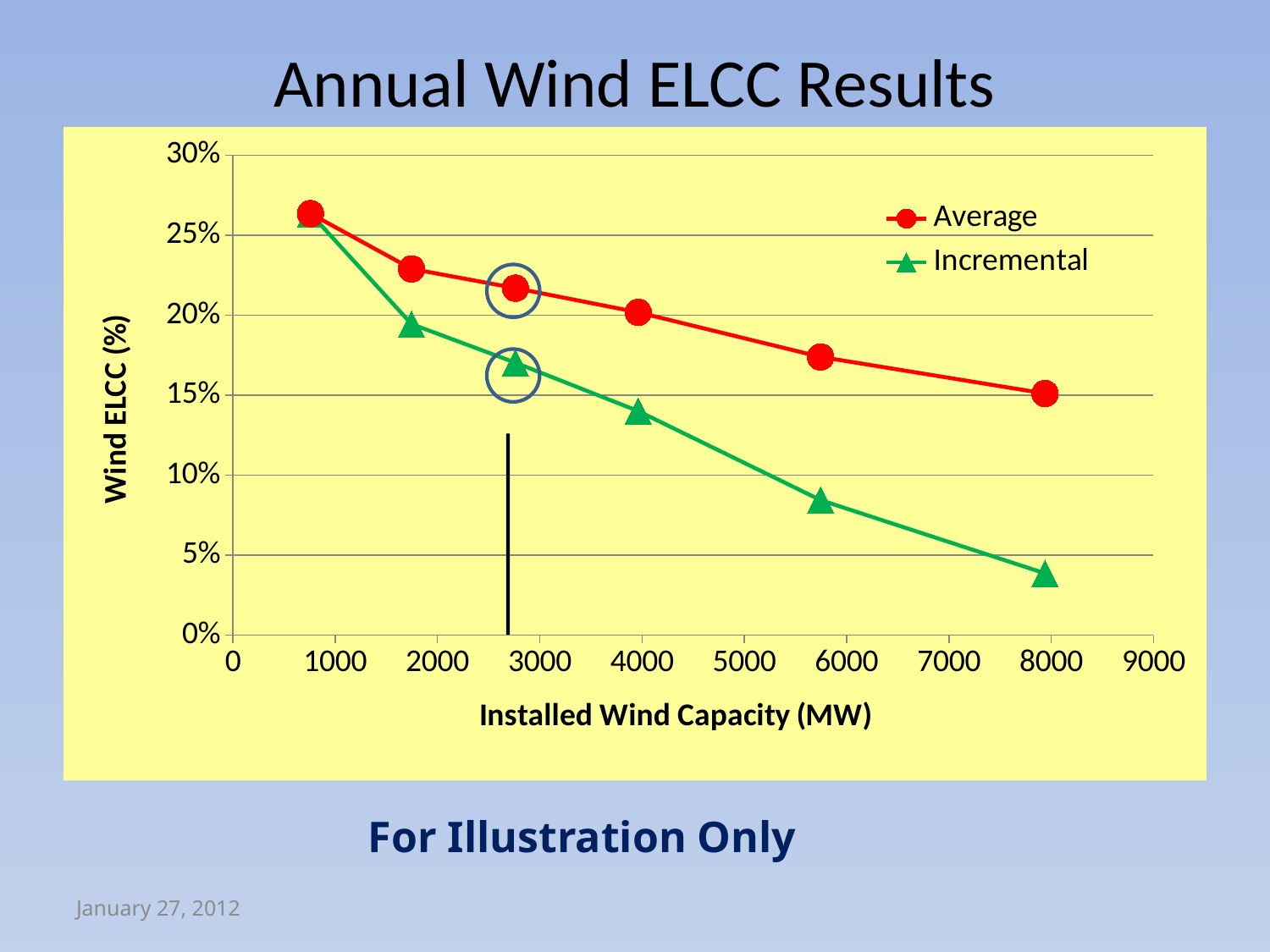
What is the label of the x axis? Installed Wind Capacity (MW) Is the value of the Average point near 1750 MW greater or less than 20%? greater What kind of chart is shown on the slide? line chart Is the value of the Incremental point near 5750 MW greater or less than 10%? less At about 4000 MW of installed wind capacity, which series has the larger value, Average or Incremental? Average Does the Incremental series rise or fall as installed wind capacity increases? fall Does the Average series rise or fall as installed wind capacity increases? fall Is the value of the Average point near 5750 MW greater or less than 20%? less Which series is drawn with green triangle markers? Incremental How many data points are plotted for the Average series? 6 How many series does the legend list? 2